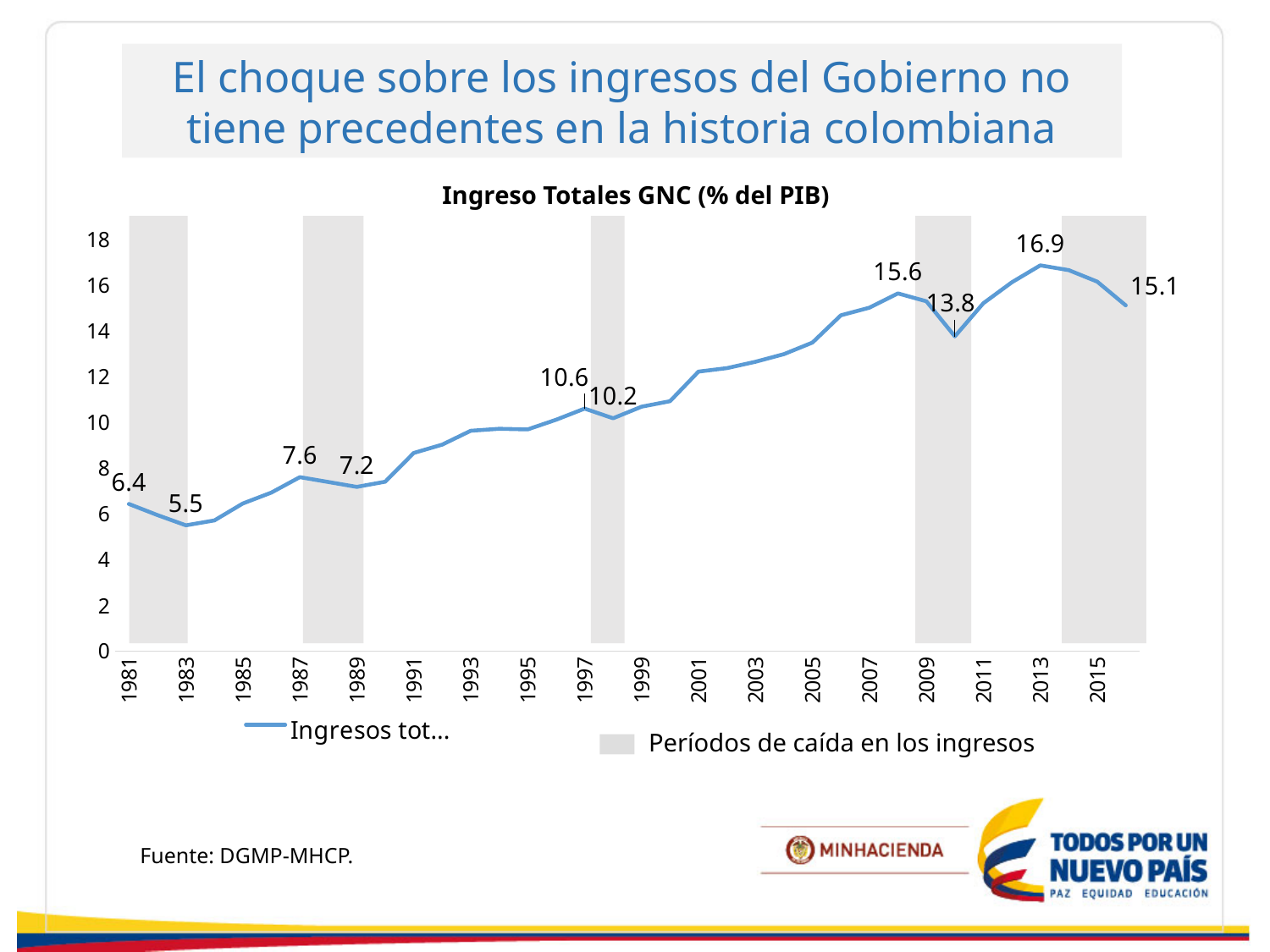
What kind of chart is shown on the slide? line chart What is the difference between the value for 1987 and the value for 1989? 0.4 Which labeled value on the line is the lowest? 5.5 What is the value for 2013? 16.9 What is the value for 1987? 7.6 Which is larger, the value for 1981 or the value for 1983? 1981 Which labeled value on the line is the highest? 16.9 What is the value for 1981? 6.4 What is the value of the last point on the line? 15.1 What is the title of the chart? Ingreso Totales GNC (% del PIB) What is the value for 1983? 5.5 Is the value for 1993 greater or less than 10? less